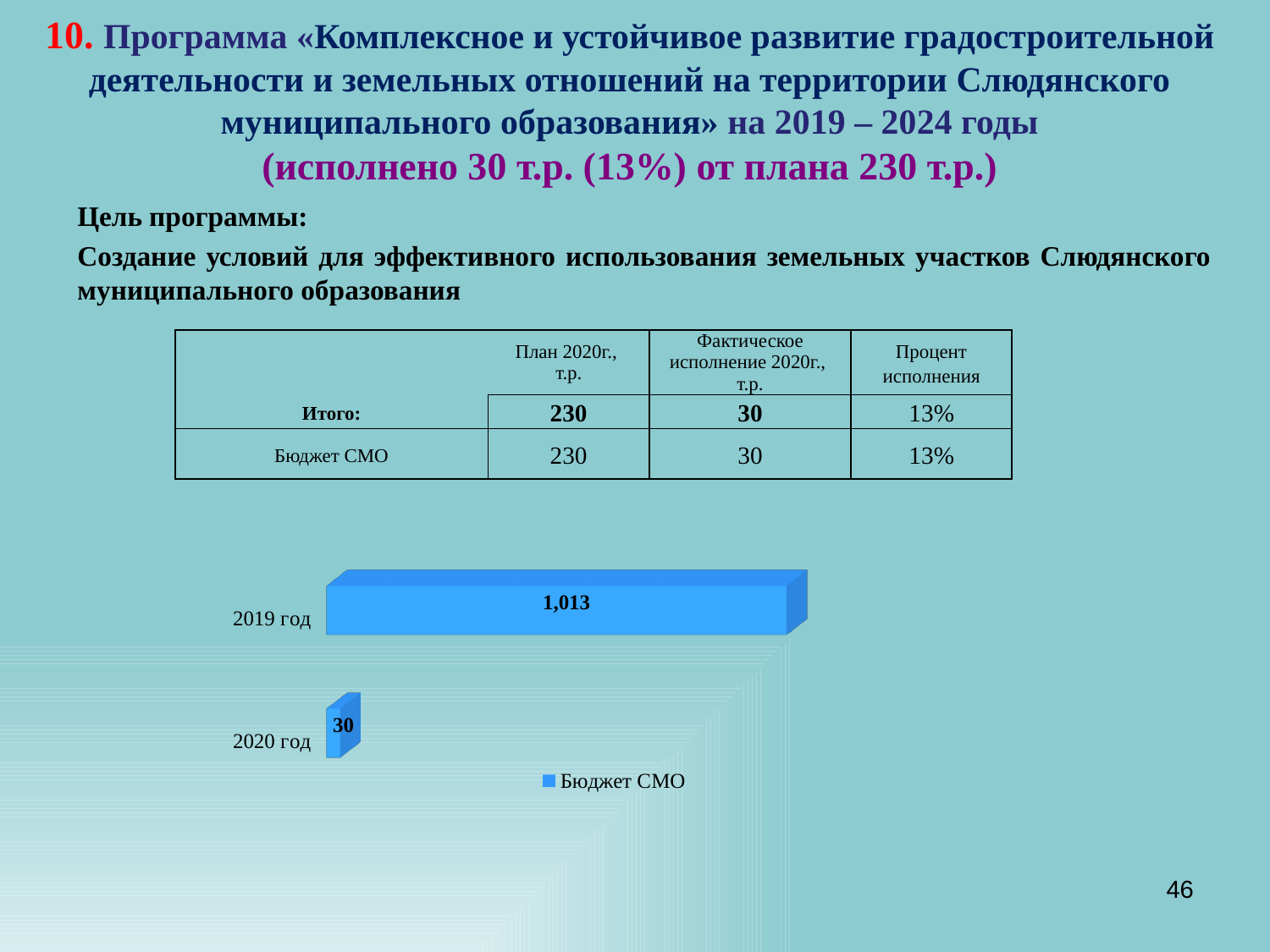
What series name is shown in the chart legend? Бюджет СМО What is the difference between the values for 2019 год and 2020 год? 983 What colour are the bars in the chart? Blue What is the value of the bar for 2020 год? 30 Which is larger, the value for 2019 год or the value for 2020 год? 2019 год How many categories (years) are shown in the chart? 2 Which year has the lowest value in the chart? 2020 год How many series does the chart legend list? 1 Do the values rise or fall from 2019 год to 2020 год? Fall Which year has the highest value in the chart? 2019 год What kind of chart is shown on the slide? Bar chart What is the value of the bar for 2019 год? 1,013